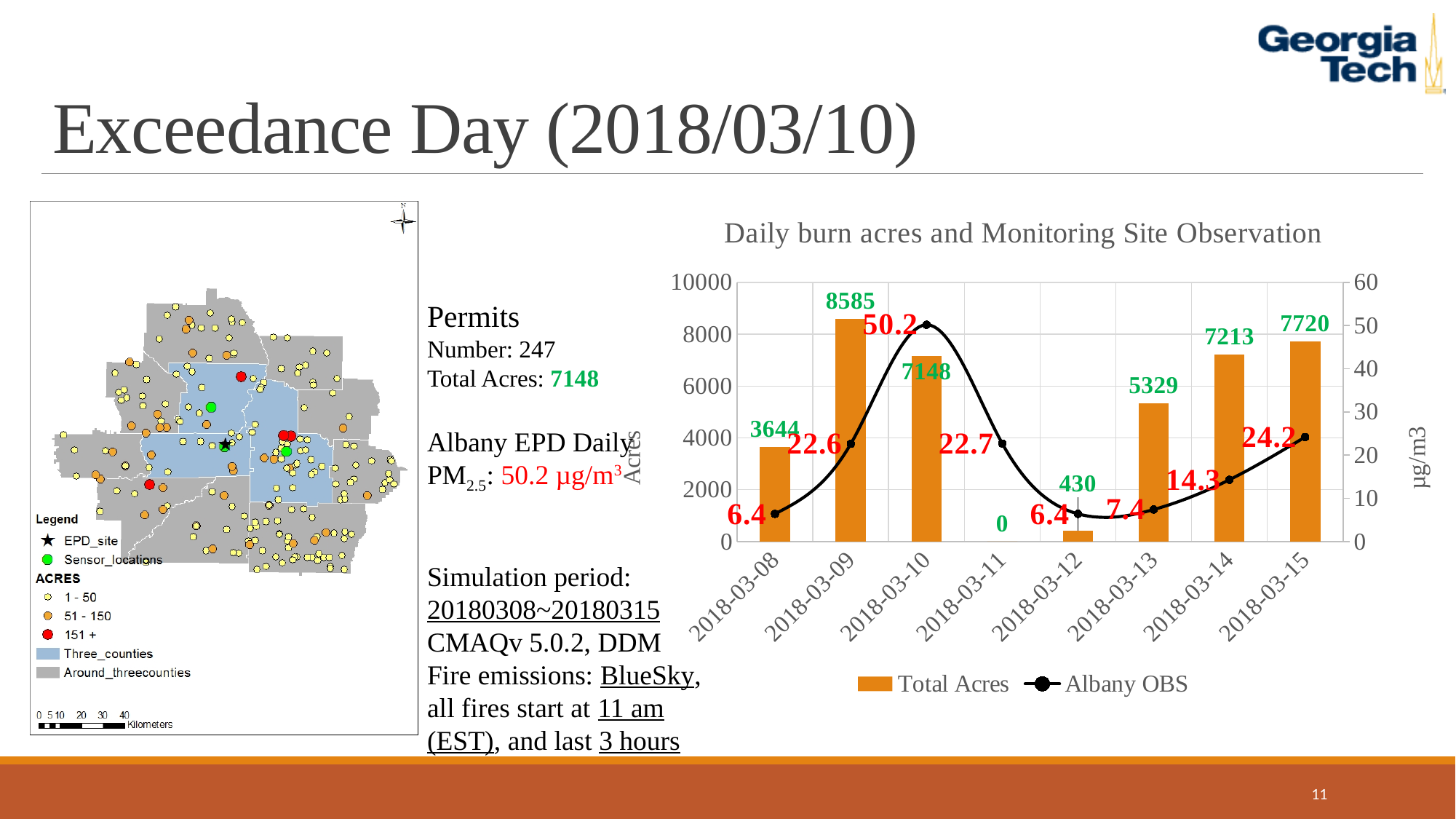
Which date has the highest Albany OBS value? 2018-03-10 What is the difference in Total Acres between 2018-03-15 and 2018-03-14? 507 Which is larger, the Albany OBS value for 2018-03-09 or for 2018-03-11? 2018-03-11 What is the Total Acres value for 2018-03-09? 8585 Which date has the lowest Total Acres? 2018-03-11 Which date has the highest Total Acres? 2018-03-09 How many series does the chart legend list? 2 What is the title of the chart on the slide? Daily burn acres and Monitoring Site Observation What is the Total Acres value for 2018-03-12? 430 How many dates are shown on the x axis of the chart? 8 What is the Albany OBS value for 2018-03-10? 50.2 Does the Albany OBS value rise or fall from 2018-03-12 to 2018-03-15? rise